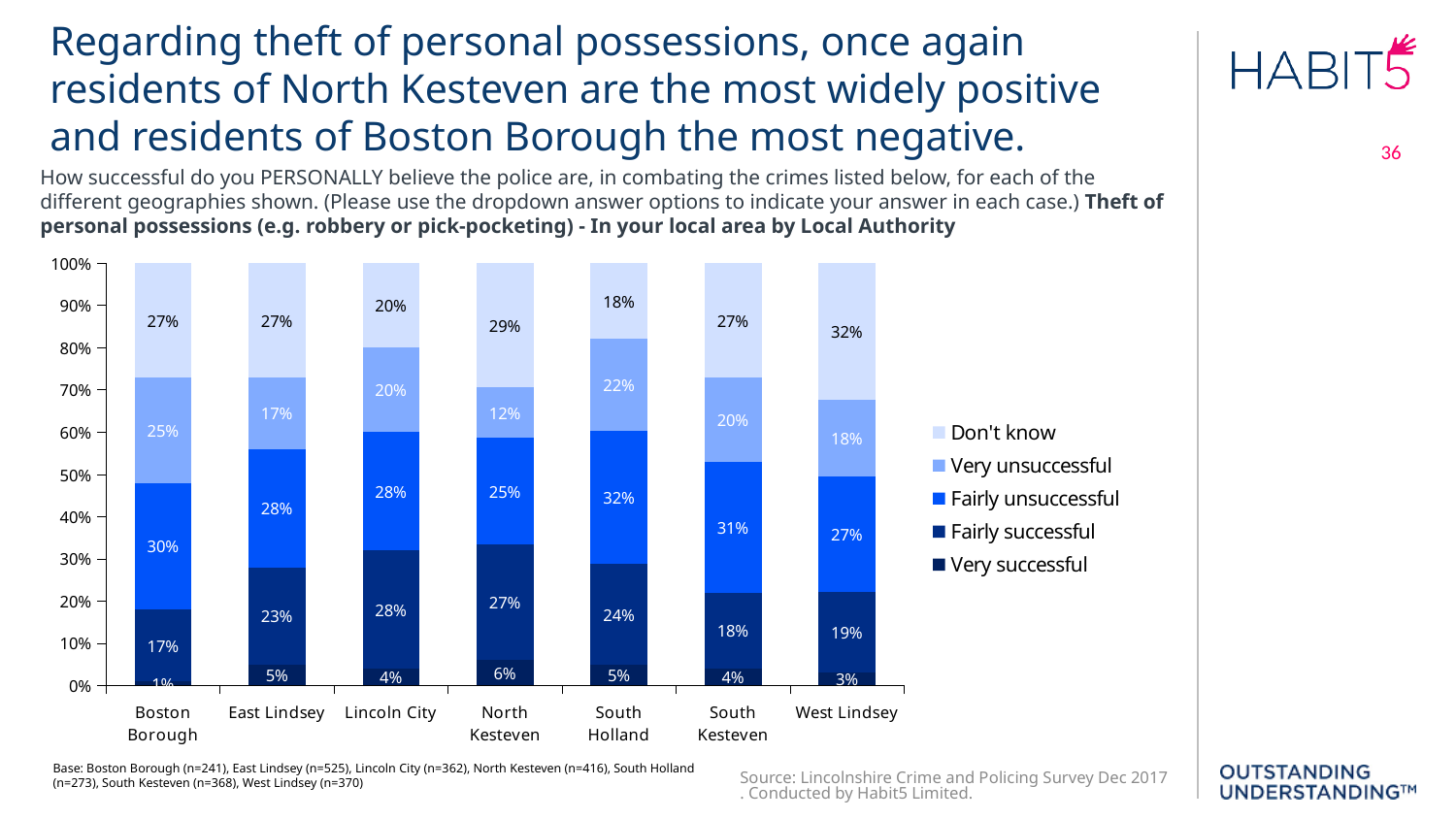
What percentage of South Holland respondents said the police are fairly unsuccessful? 32% Which series appears at the bottom of each stacked bar? Very successful What kind of chart is shown on the slide? Stacked bar chart Which local authority has the lowest 'Very successful' share? Boston Borough How many local authorities are shown on the x axis? 7 Which local authority has the highest 'Fairly successful' share? Lincoln City What is the difference in the 'Fairly successful' share between Lincoln City and Boston Borough? 11 percentage points How many series does the legend list? 5 What is the 'Very successful' value for North Kesteven? 6% Which local authority has the highest 'Don't know' share? West Lindsey What is the 'Don't know' value for Lincoln City? 20% Which has a larger 'Very unsuccessful' share, Boston Borough or North Kesteven? Boston Borough